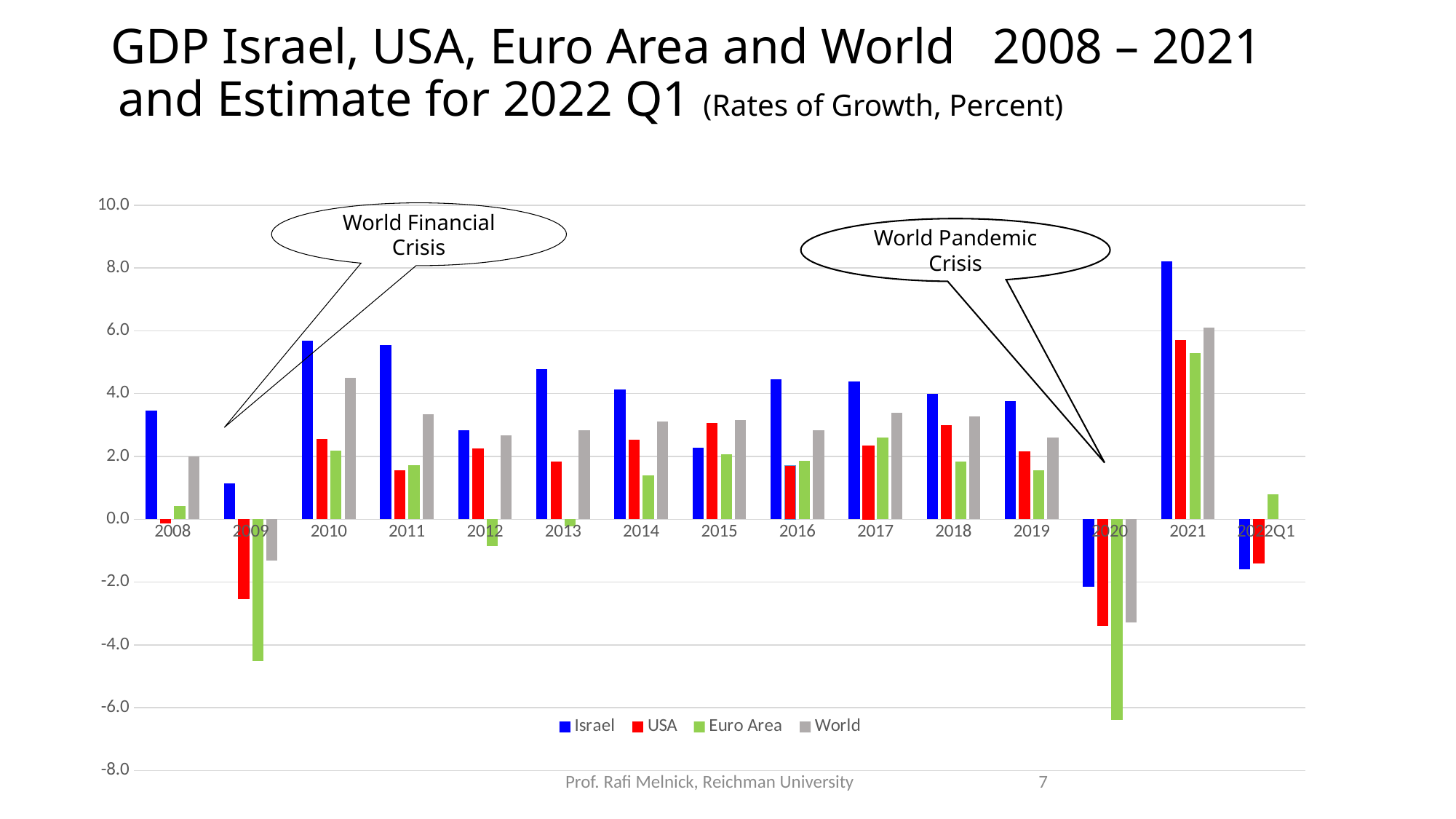
What kind of chart is shown on the slide? bar chart Which series is shown in green in the legend? Euro Area In 2015, which is larger: the USA value or the Israel value? USA Is the value for USA in 2020 greater or less than -2.0? less In which year is the Israel bar highest? 2021 In which year is the Euro Area bar lowest? 2020 Is the value for Israel in 2010 greater or less than 4.0? greater In 2020, which is lower: the Euro Area value or the USA value? Euro Area How many series does the legend list? 4 How many year categories are shown along the x axis? 15 Is the value for Euro Area in 2009 greater or less than -4.0? less Does the Israel value rise or fall from 2010 to 2012? fall